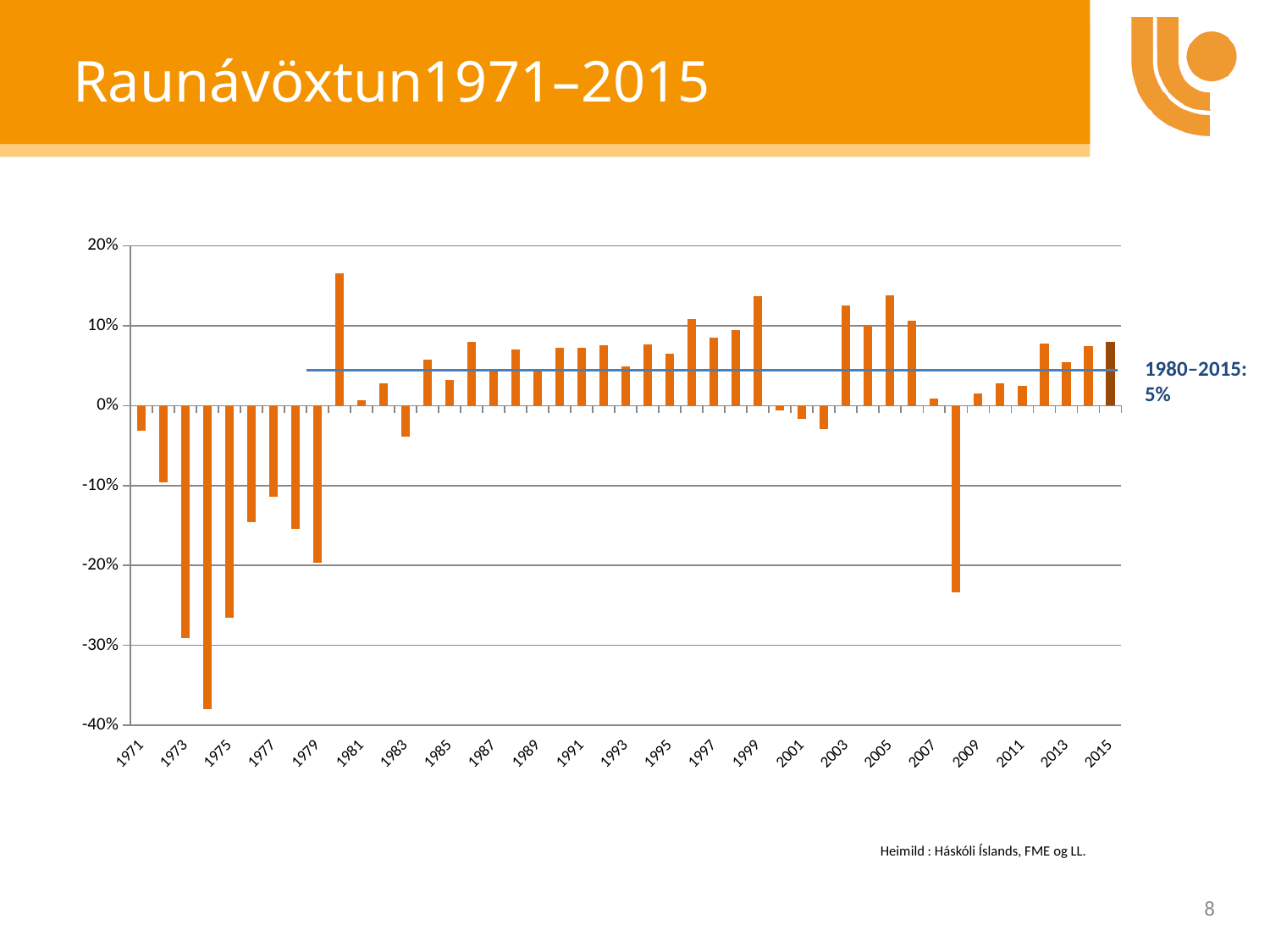
Which is larger, the value for 1975 or the value for 1977? 1977 Is the value for 1980 greater or less than 10%? greater Is the value for 1974 greater or less than -30%? less Which is larger, the value for 1980 or the value for 2005? 1980 Which year has the lowest value in the chart? 1974 Is the value for 1997 greater or less than 10%? less What average value does the horizontal line labelled 1980–2015 represent? 5% What kind of chart is shown on the slide? bar chart Which year has the highest value in the chart? 1980 Do the values rise or fall from 1971 to 1974? fall